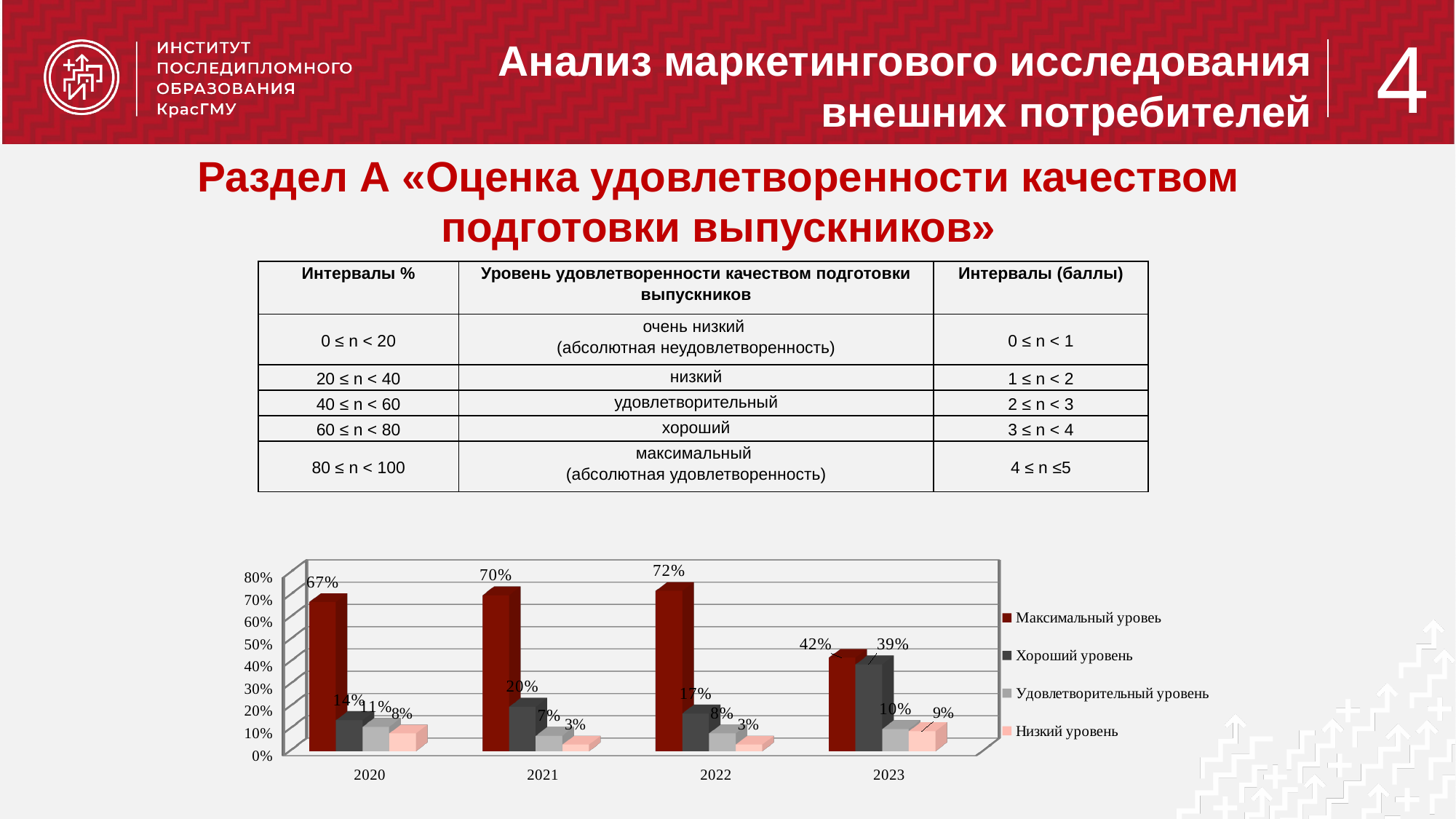
Which series is shown in dark red in the chart? Максимальный уровень What kind of chart is shown on the slide? Bar chart What is the difference between the Максимальный уровень values for 2022 and 2023? 30% What is the value for Максимальный уровень in 2022? 72% How many years are shown on the x axis of the chart? 4 What is the value for Низкий уровень in 2021? 3% Which is larger in 2021: Хороший уровень or Удовлетворительный уровень? Хороший уровень How many series does the chart legend list? 4 What is the value for Хороший уровень in 2023? 39% What is the value for Удовлетворительный уровень in 2020? 11% In which year is the value for Максимальный уровень the lowest? 2023 In which year is the value for Максимальный уровень the highest? 2022